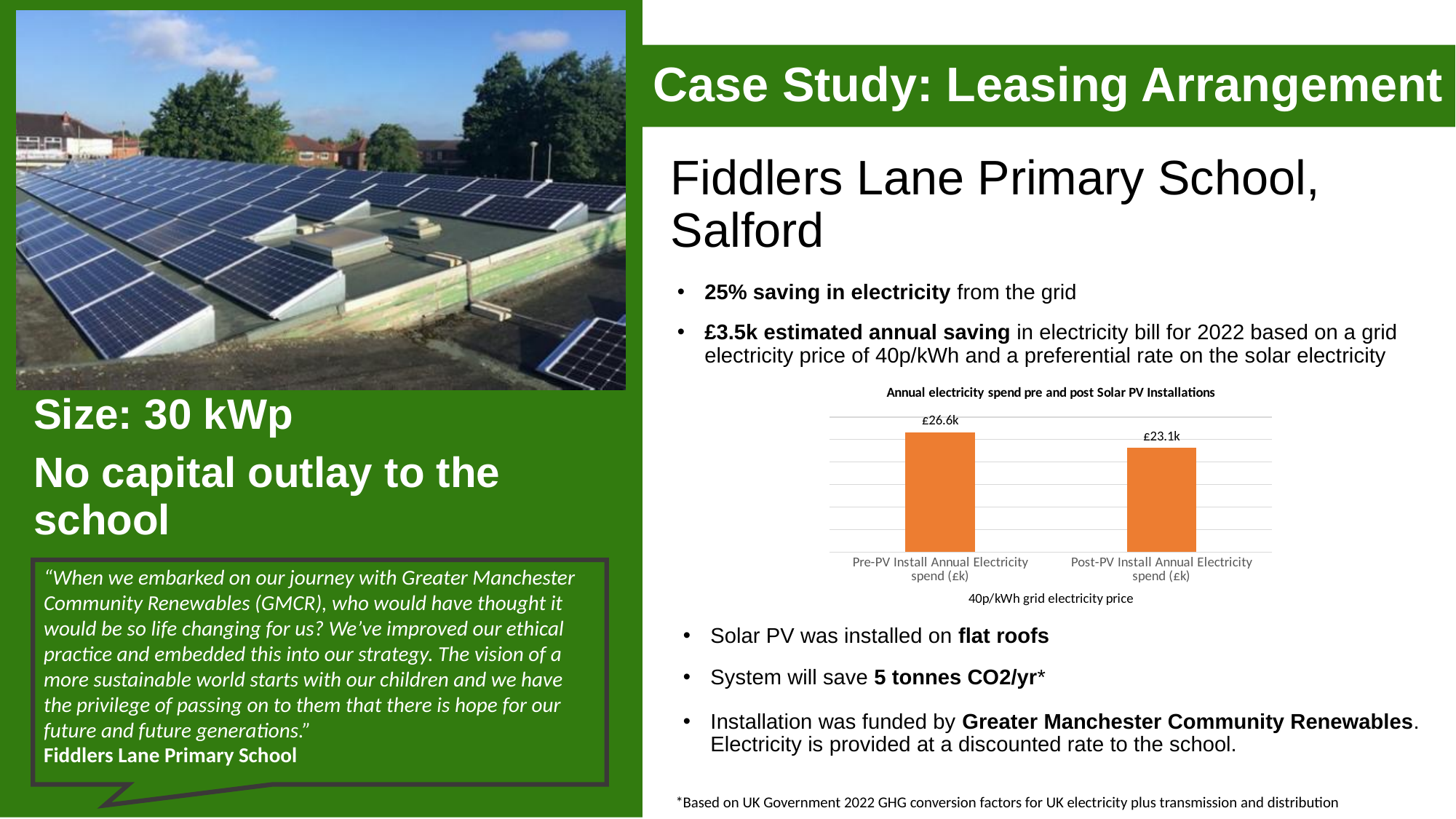
What type of chart is shown on the slide? bar chart What is the title of the chart? Annual electricity spend pre and post Solar PV Installations What is the annual electricity spend for the Post-PV Install category? £23.1k What grid electricity price is stated beneath the chart? 40p/kWh grid electricity price Which category has the higher annual electricity spend? Pre-PV Install Annual Electricity spend (£k) Which category has the lower annual electricity spend? Post-PV Install Annual Electricity spend (£k) What is the difference between the Pre-PV and Post-PV annual electricity spend? £3.5k Do the values rise or fall from the Pre-PV bar to the Post-PV bar? fall What is the annual electricity spend for the Pre-PV Install category? £26.6k Is the Pre-PV Install spend larger or smaller than the Post-PV Install spend? larger How many bars are shown in the chart? 2